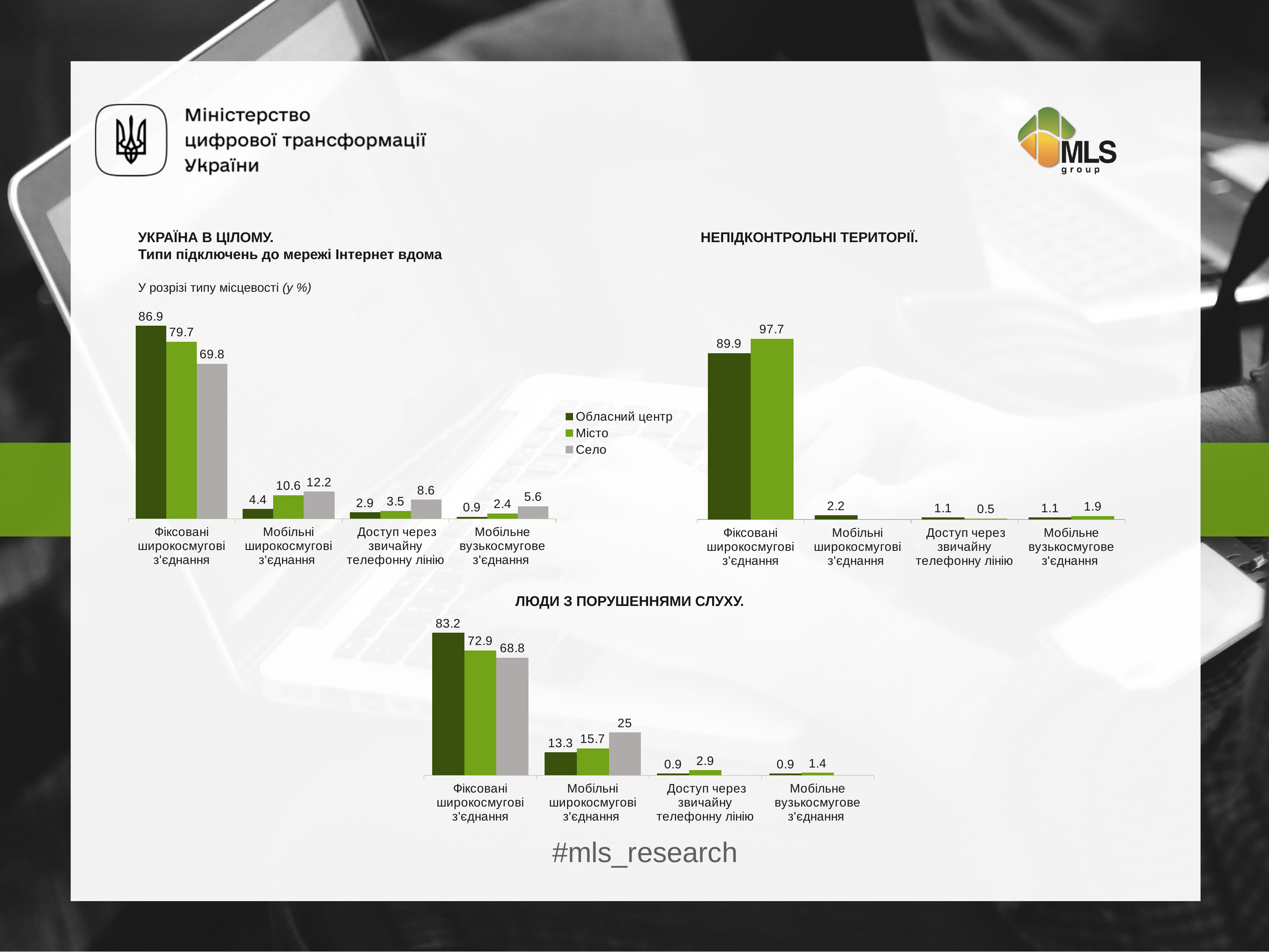
In the 'НЕПІДКОНТРОЛЬНІ ТЕРИТОРІЇ' chart, what is the value for 'Обласний центр' in the 'Мобільні широкосмугові з'єднання' category? 2.2 How many series does the legend on the slide list? 3 In the 'ЛЮДИ З ПОРУШЕННЯМИ СЛУХУ' chart, which category has the lowest value for 'Місто'? Мобільне вузькосмугове з'єднання In the 'НЕПІДКОНТРОЛЬНІ ТЕРИТОРІЇ' chart, what is the value for 'Місто' in the 'Фіксовані широкосмугові з'єднання' category? 97.7 In the 'УКРАЇНА В ЦІЛОМУ' chart, what is the value for 'Село' in the 'Фіксовані широкосмугові з'єднання' category? 69.8 In the 'ЛЮДИ З ПОРУШЕННЯМИ СЛУХУ' chart, what is the value for 'Село' in the 'Мобільні широкосмугові з'єднання' category? 25 In the 'НЕПІДКОНТРОЛЬНІ ТЕРИТОРІЇ' chart, which is larger for 'Доступ через звичайну телефонну лінію': 'Обласний центр' or 'Місто'? Обласний центр In the 'УКРАЇНА В ЦІЛОМУ' chart, what is the value for 'Обласний центр' in the 'Мобільні широкосмугові з'єднання' category? 4.4 How many categories are shown on the x axis of the 'ЛЮДИ З ПОРУШЕННЯМИ СЛУХУ' chart? 4 In the 'ЛЮДИ З ПОРУШЕННЯМИ СЛУХУ' chart, what is the difference between the 'Обласний центр' and 'Місто' values for 'Фіксовані широкосмугові з'єднання'? 10.3 In the 'УКРАЇНА В ЦІЛОМУ' chart, which series has the highest value for 'Доступ через звичайну телефонну лінію'? Село In the 'УКРАЇНА В ЦІЛОМУ' chart, what is the difference between the 'Обласний центр' and 'Село' values for 'Фіксовані широкосмугові з'єднання'? 17.1